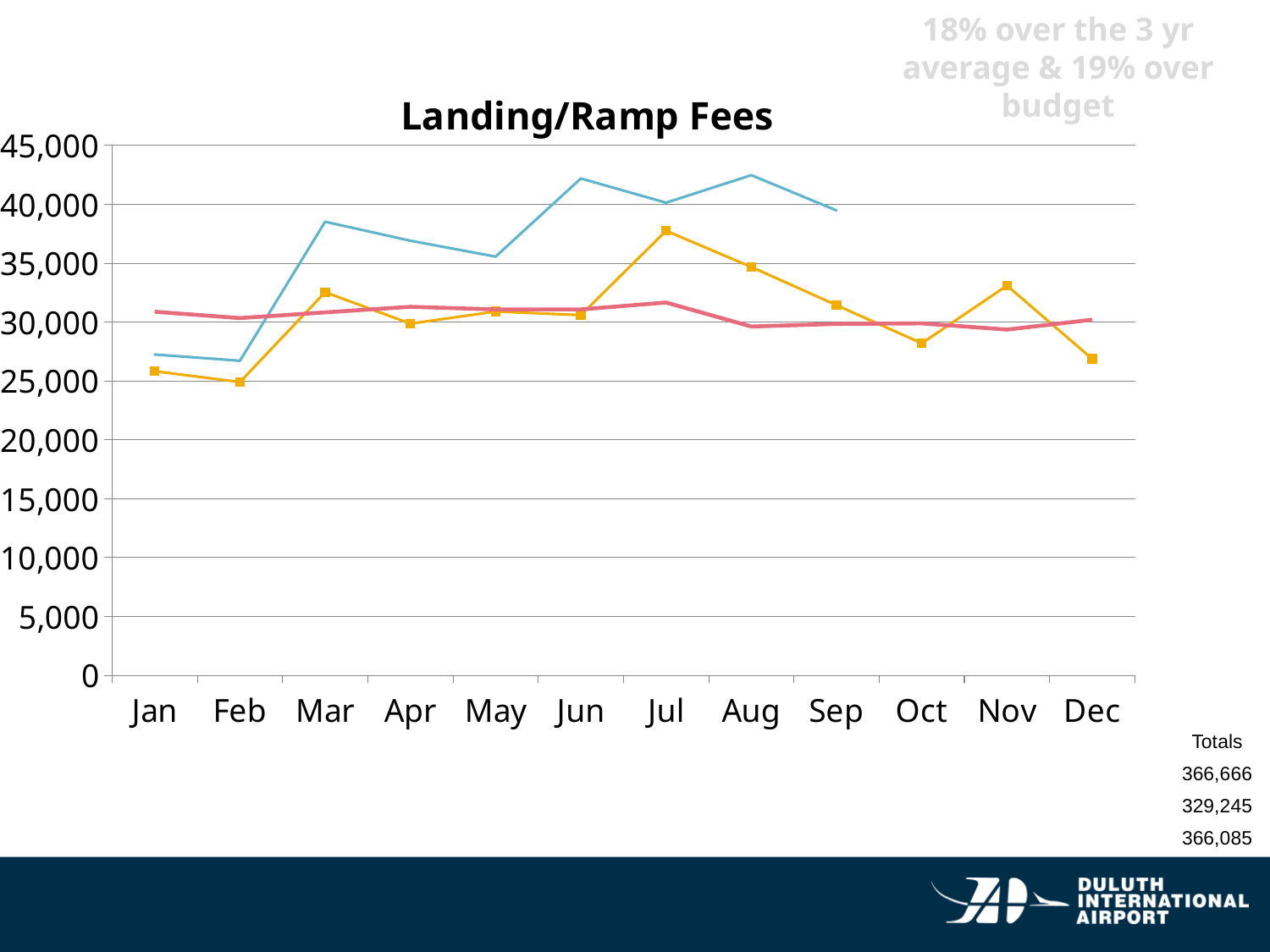
Does the orange line rise or fall from Jul to Oct? Fall In which month does the orange line with square markers reach its highest value? Jul How many months are shown on the x axis of the chart? 12 What is the title of the chart? Landing/Ramp Fees In Nov, which line has the higher value, the orange line or the red line? The orange line In which month does the orange line with square markers reach its lowest value? Feb Is the value of the blue line in Jan greater or less than 30,000? less What type of chart is shown on the slide? Line chart How many lines are plotted on the chart? 3 In Jul, which line has the higher value, the blue line or the orange line? The blue line Is the value of the blue line in Jun greater or less than 40,000? greater Is the value of the orange line in Dec greater or less than 30,000? less